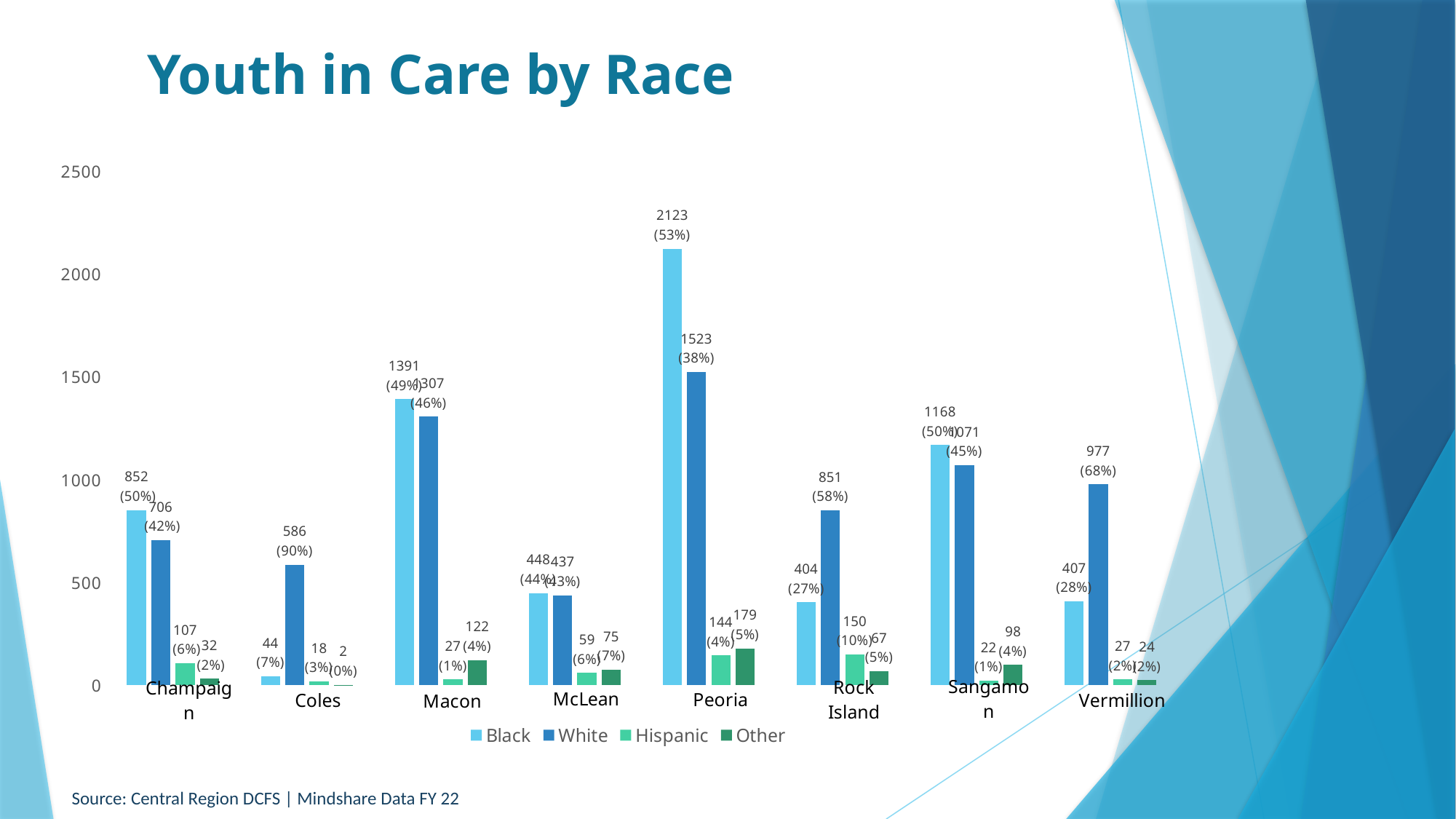
How many series does the legend list? 4 What kind of chart is shown on the slide? bar chart What is the value for Hispanic in Rock Island? 150 (10%) What is the title of the chart? Youth in Care by Race Which county has the highest value for Black? Peoria Which county has the lowest value for Other? Coles How many counties are shown on the x axis? 8 Is the value for White in Vermillion greater or less than 500? greater What is the difference between the Black and White values in Peoria? 600 What is the value for White in Coles? 586 (90%) In Rock Island, which is larger, the Black value or the White value? White What is the value for Black in Peoria? 2123 (53%)